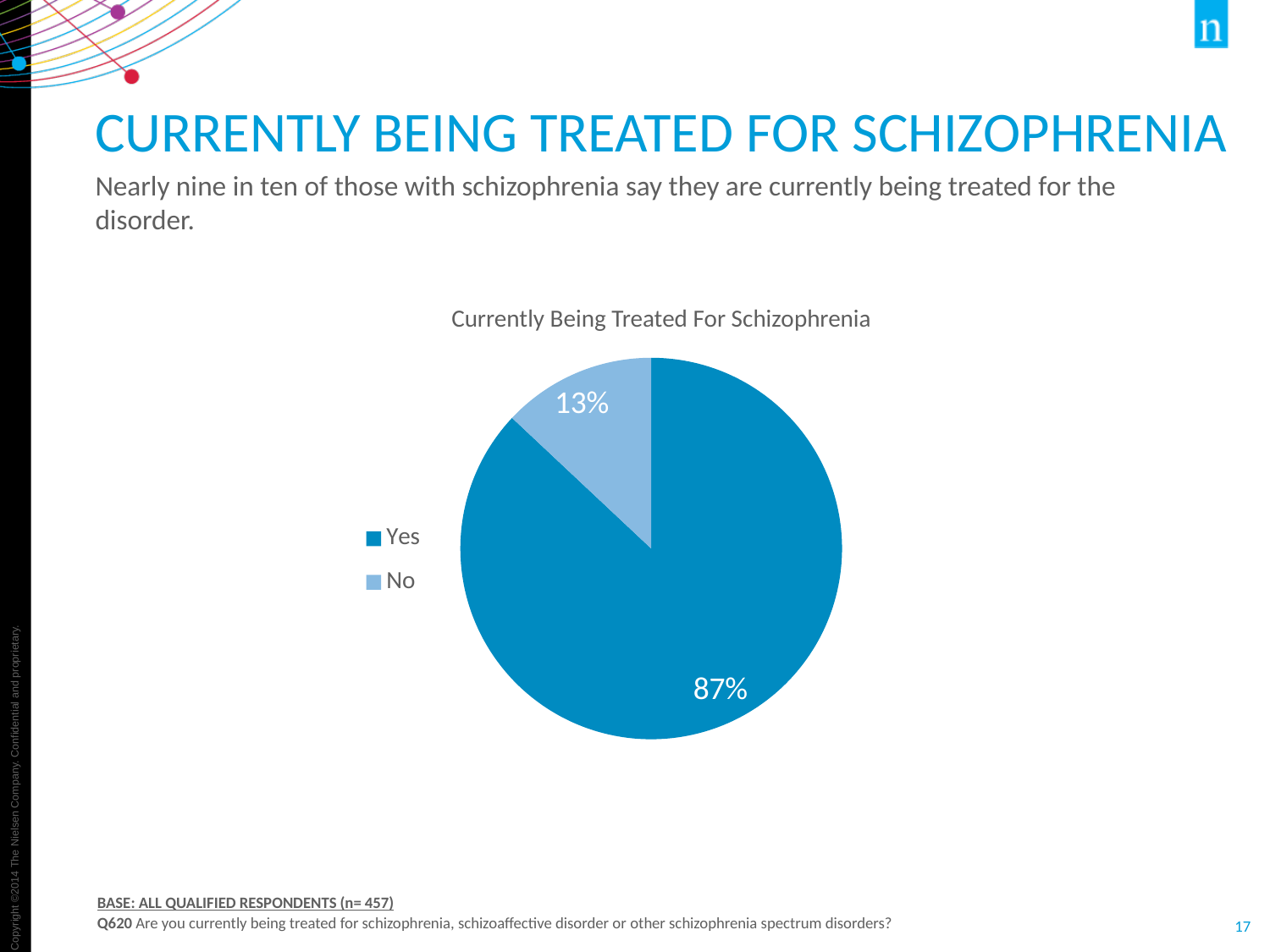
How many categories does the pie chart show? 2 What share of the pie does the No slice represent? 13% What is the difference in percentage points between the Yes and No slices? 74 Which slice is larger, Yes or No? Yes Which legend entry is shown in the lighter blue colour? No What kind of chart is shown on the slide? pie chart What percentage of respondents answered Yes? 87% What is the title of the chart? Currently Being Treated For Schizophrenia Which category has the smallest share of the pie? No Which category has the largest share of the pie? Yes What percentage of respondents answered No? 13%